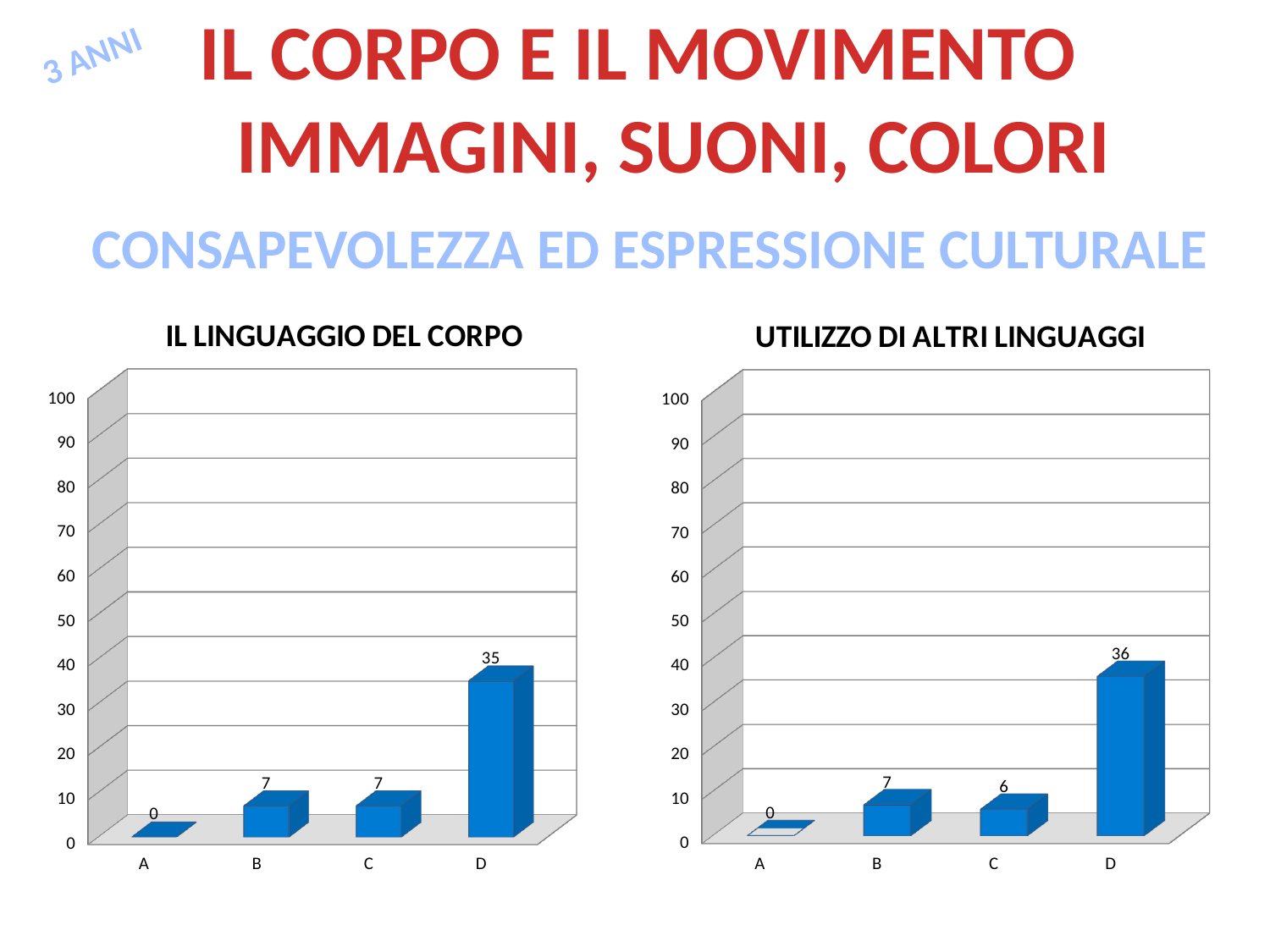
In the chart titled "IL LINGUAGGIO DEL CORPO", which category has the lowest value? A In the chart titled "UTILIZZO DI ALTRI LINGUAGGI", what is the difference between the values for D and B? 29 In the chart titled "IL LINGUAGGIO DEL CORPO", is the value for D greater or less than 30? greater In the chart titled "IL LINGUAGGIO DEL CORPO", what is the value for category B? 7 What kind of chart is the chart titled "IL LINGUAGGIO DEL CORPO"? Bar chart In the chart titled "UTILIZZO DI ALTRI LINGUAGGI", what is the value for category C? 6 In the chart titled "UTILIZZO DI ALTRI LINGUAGGI", which category has the highest value? D In the chart titled "IL LINGUAGGIO DEL CORPO", what is the difference between the values for D and C? 28 How many categories are shown in the chart titled "UTILIZZO DI ALTRI LINGUAGGI"? 4 In the chart titled "UTILIZZO DI ALTRI LINGUAGGI", which is larger, the value for B or the value for C? B In the chart titled "IL LINGUAGGIO DEL CORPO", what is the value for category D? 35 What is the title of the chart on the right side of the slide? UTILIZZO DI ALTRI LINGUAGGI